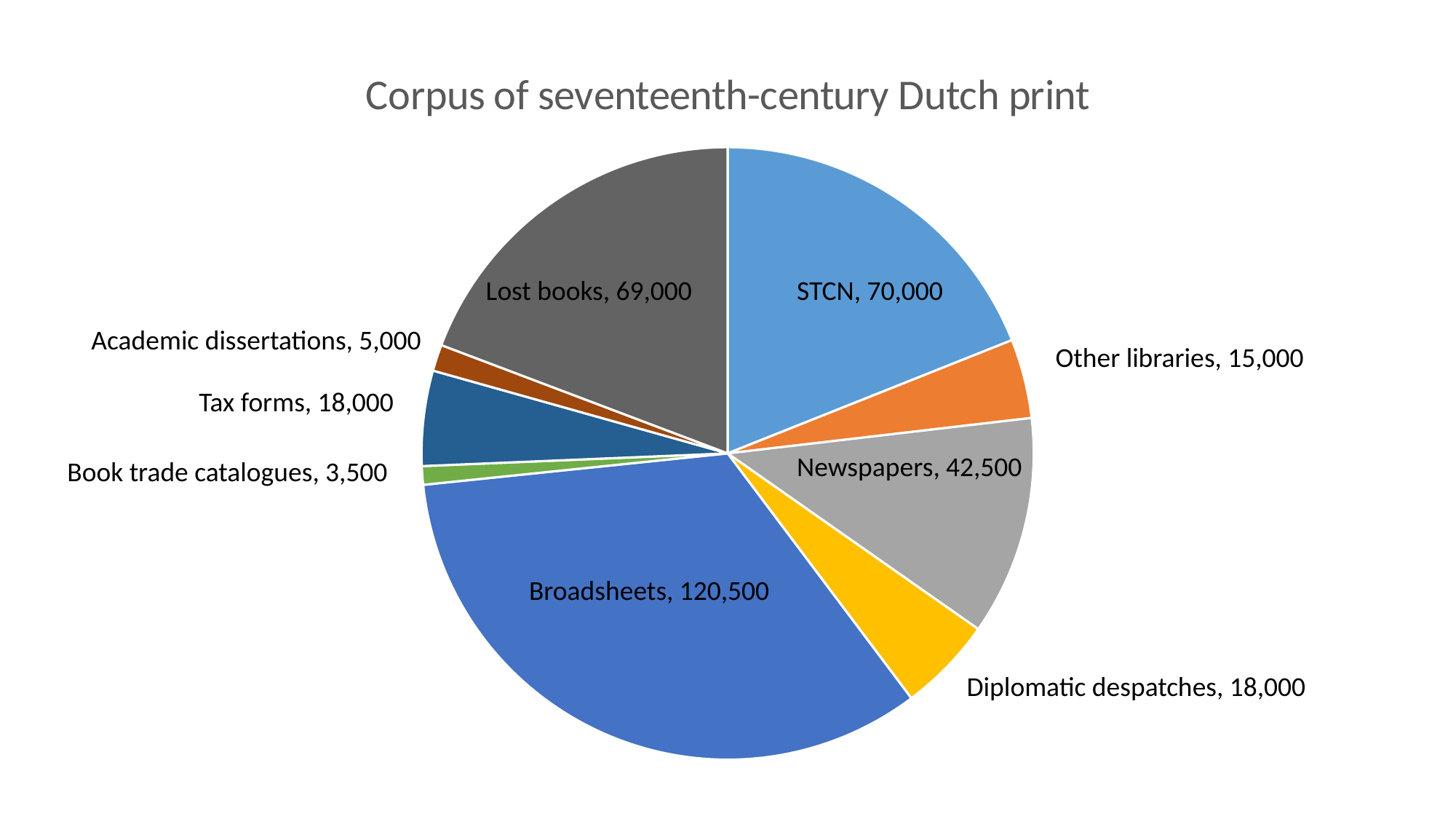
What is the value for Book trade catalogues? 3,500 What is the value for Broadsheets? 120,500 Which two categories both have a value of 18,000? Tax forms and Diplomatic despatches What is the difference between the values for Broadsheets and Newspapers? 78,000 What kind of chart is shown on the slide? Pie chart Which category has the smallest slice? Book trade catalogues What is the value for Newspapers? 42,500 What is the difference between the values for STCN and Lost books? 1,000 How many slices does the pie chart have? 9 Which is larger, Newspapers or Other libraries? Newspapers What is the title of the chart? Corpus of seventeenth-century Dutch print Which category has the largest slice? Broadsheets